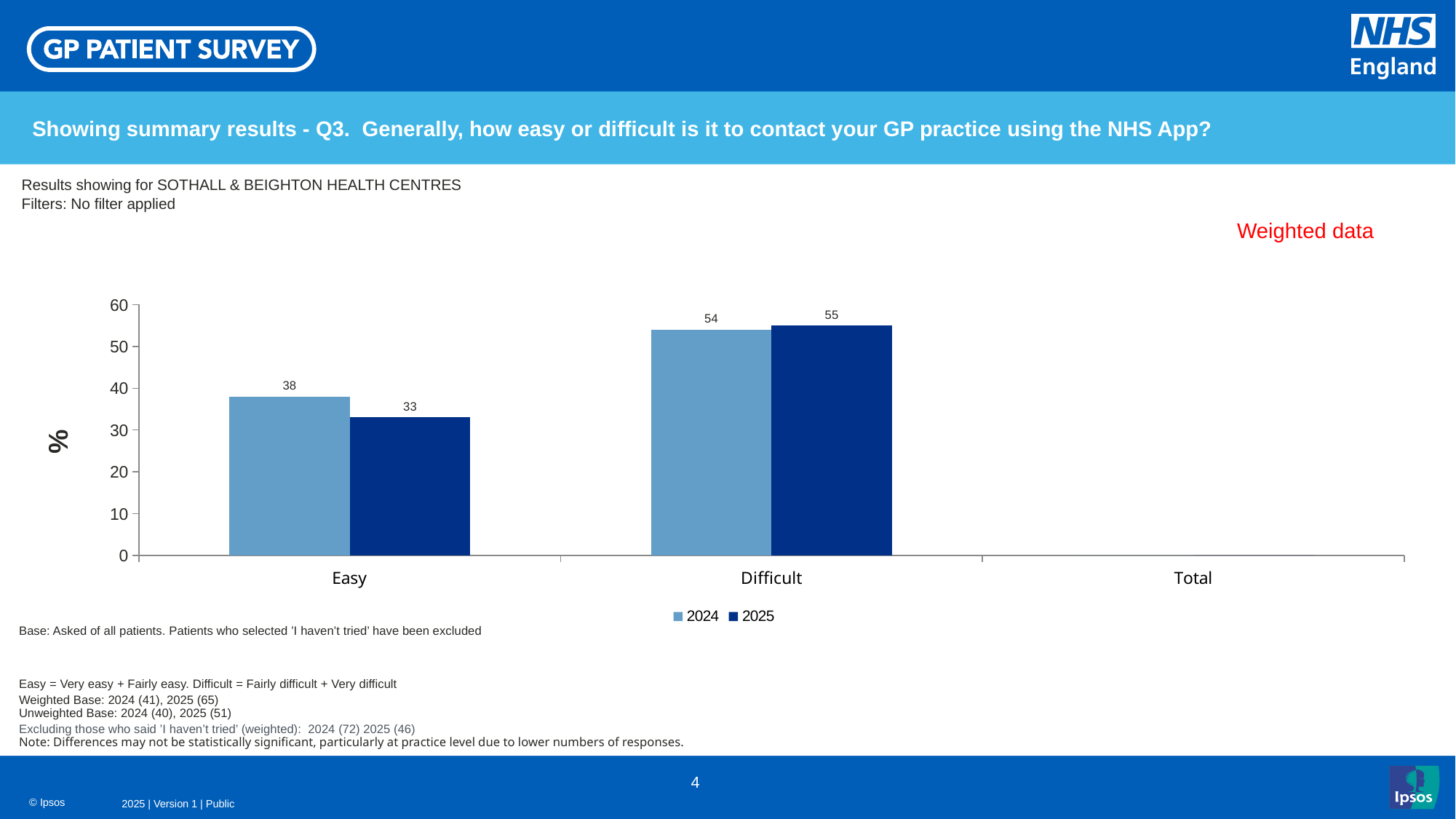
What label is shown on the vertical axis? % What is the difference between the 2024 and 2025 values for Easy? 5 What is the value for Difficult in 2024? 54 Which is larger, the 2024 value for Easy or the 2024 value for Difficult? Difficult How many series does the legend list? 2 What kind of chart is shown on the slide? Bar chart Is the value for Difficult in 2025 greater or less than 50? greater Which category has the highest value for 2025? Difficult Which category has the lowest value for 2024? Easy What is the value for Difficult in 2025? 55 What is the value for Easy in 2025? 33 What is the value for Easy in 2024? 38